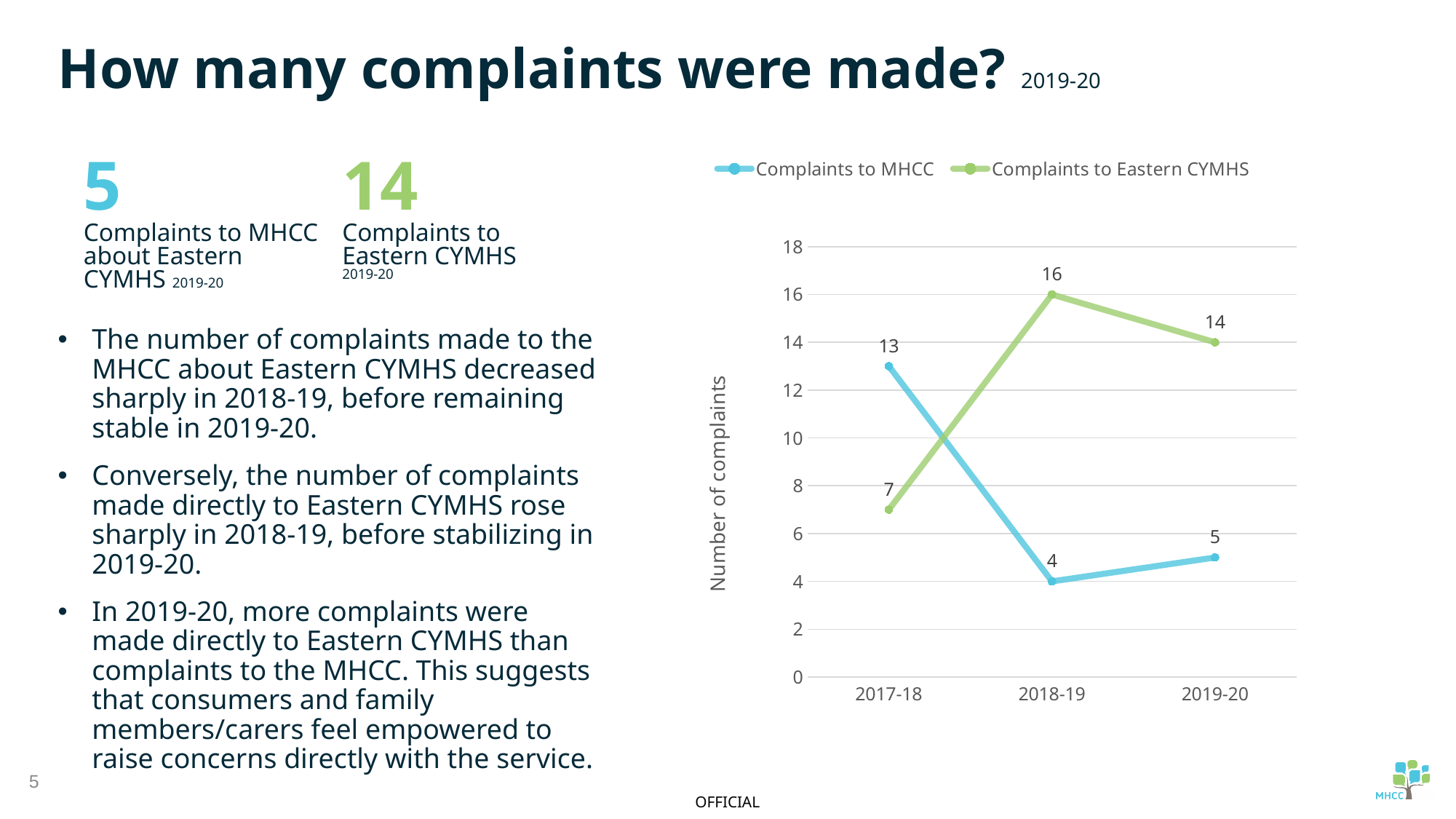
Do complaints to MHCC rise or fall from 2017-18 to 2018-19? fall What is the value for Complaints to MHCC in 2019-20? 5 How many complaints to MHCC were there in 2017-18? 13 How many years are shown on the x axis of the chart? 3 What kind of chart is shown on the slide? line chart In which year were complaints to Eastern CYMHS lowest? 2017-18 Which series had the larger value in 2017-18, Complaints to MHCC or Complaints to Eastern CYMHS? Complaints to MHCC In which year were complaints to MHCC highest? 2017-18 How many complaints to Eastern CYMHS were there in 2018-19? 16 What is the difference between complaints to Eastern CYMHS and complaints to MHCC in 2019-20? 9 What is the label of the chart's vertical axis? Number of complaints How many series does the chart legend list? 2